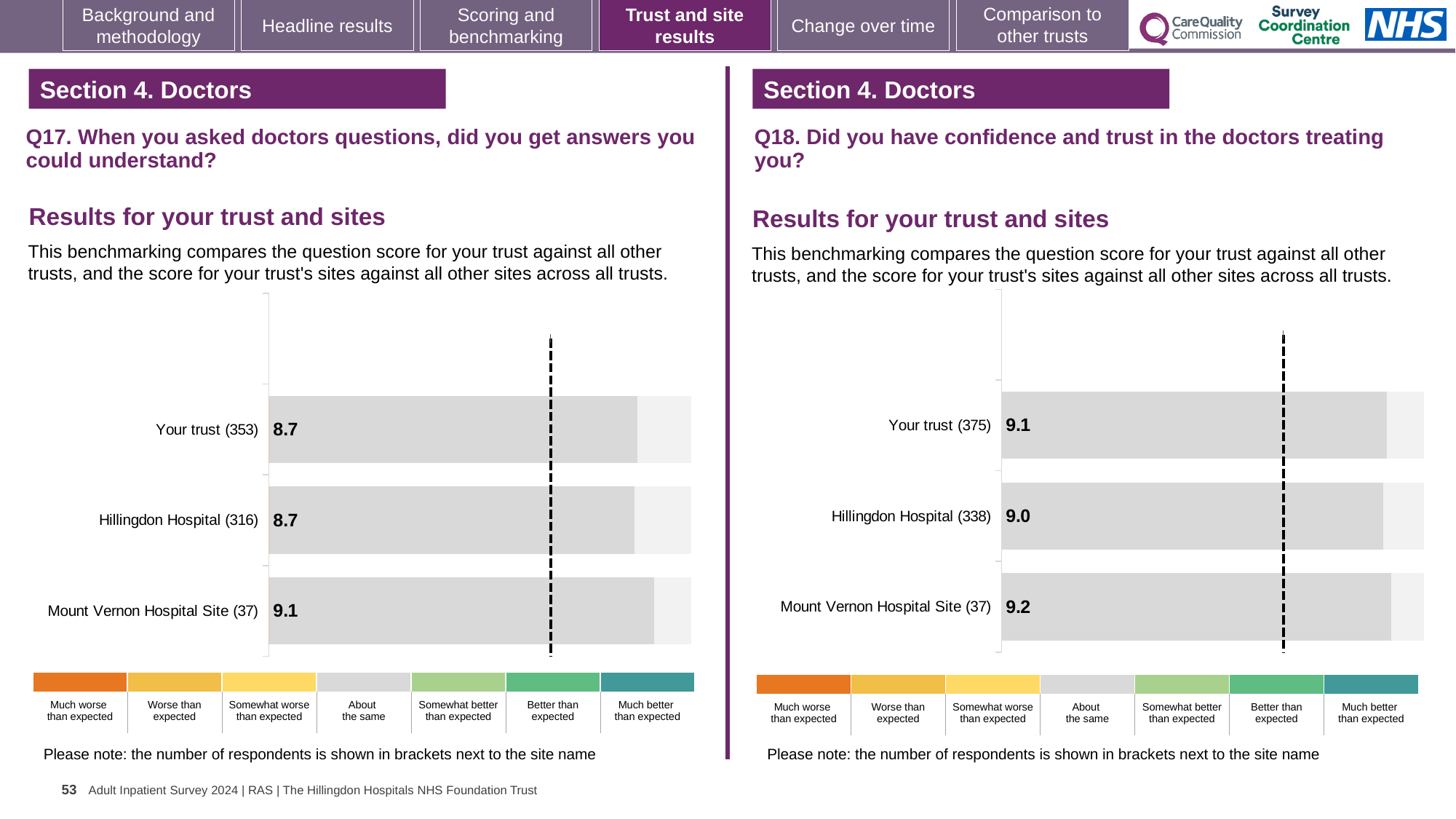
On the Q17 chart (left), what is the score for Your trust (353)? 8.7 On the Q17 chart (left), what is the score for Mount Vernon Hospital Site (37)? 9.1 How many benchmark categories are shown in the colour scale below the Q17 chart (left)? 7 On the Q17 chart (left), what is the difference between the Mount Vernon Hospital Site score and the Hillingdon Hospital score? 0.4 On the Q18 chart (right), which is larger: the score for Your trust (375) or the score for Hillingdon Hospital (338)? Your trust (375) On the Q17 chart (left), which site or trust has the highest score? Mount Vernon Hospital Site (37) On the Q18 chart (right), what is the score for Hillingdon Hospital (338)? 9.0 What kind of chart is used on the Q18 chart (right)? Bar chart On the Q18 chart (right), what is the score for Mount Vernon Hospital Site (37)? 9.2 On the Q18 chart (right), what is the difference between the Mount Vernon Hospital Site score and the Your trust score? 0.1 On the Q18 chart (right), which site or trust has the lowest score? Hillingdon Hospital (338) How many bars are plotted on the Q17 chart (left)? 3